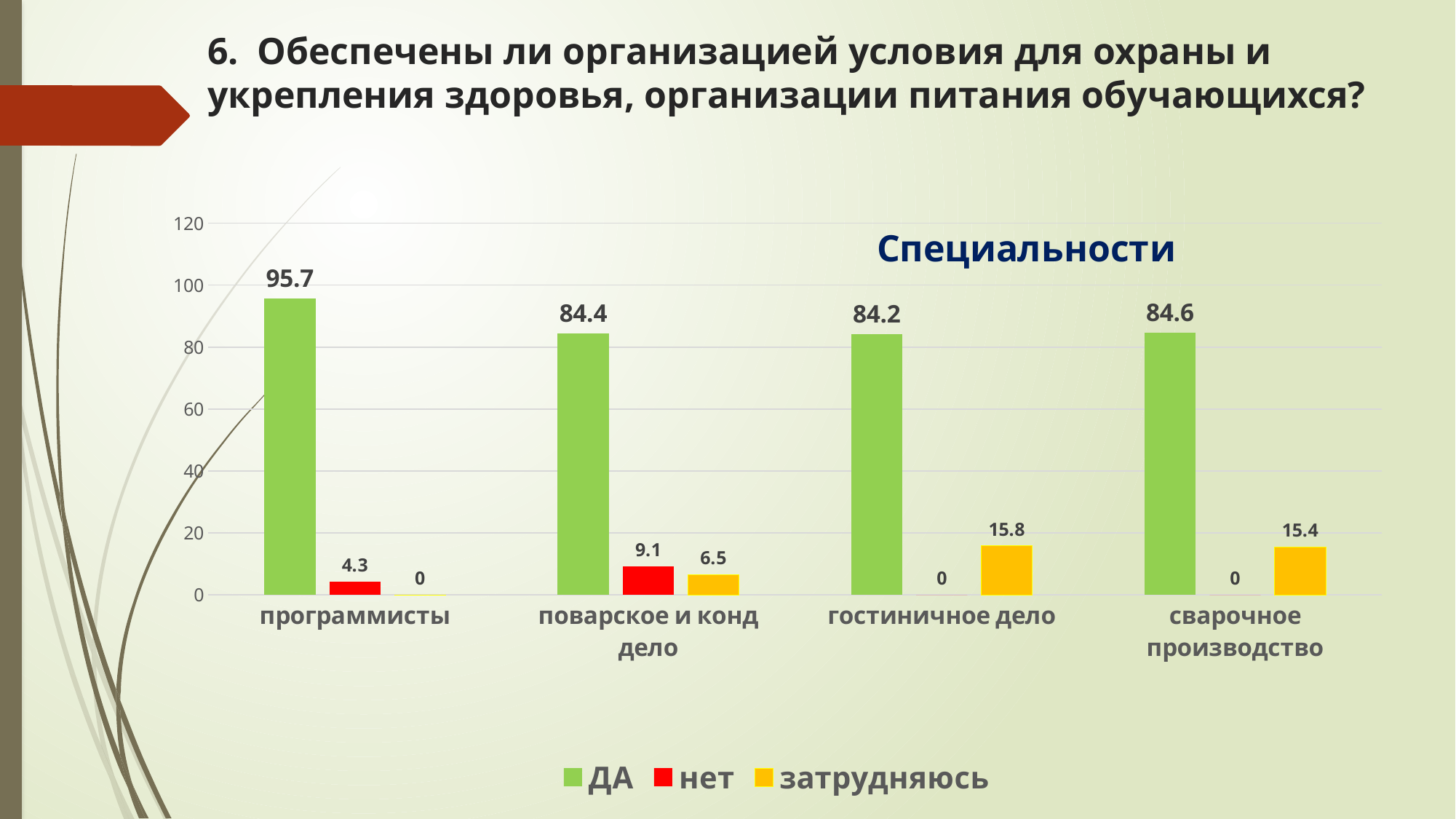
Which is larger: the затрудняюсь value for гостиничное дело or for сварочное производство? гостиничное дело What is the value of затрудняюсь for гостиничное дело? 15.8 What is the value of нет for поварское и конд дело? 9.1 What is the value of ДА for программисты? 95.7 How many categories are shown on the x axis? 4 Is the ДА value for сварочное производство greater or less than 80? greater What is the value of затрудняюсь for сварочное производство? 15.4 How many series does the legend list? 3 Which category has the lowest ДА value? гостиничное дело What kind of chart is shown on the slide? bar chart Which category has the highest ДА value? программисты What is the difference between the ДА values for программисты and поварское и конд дело? 11.3